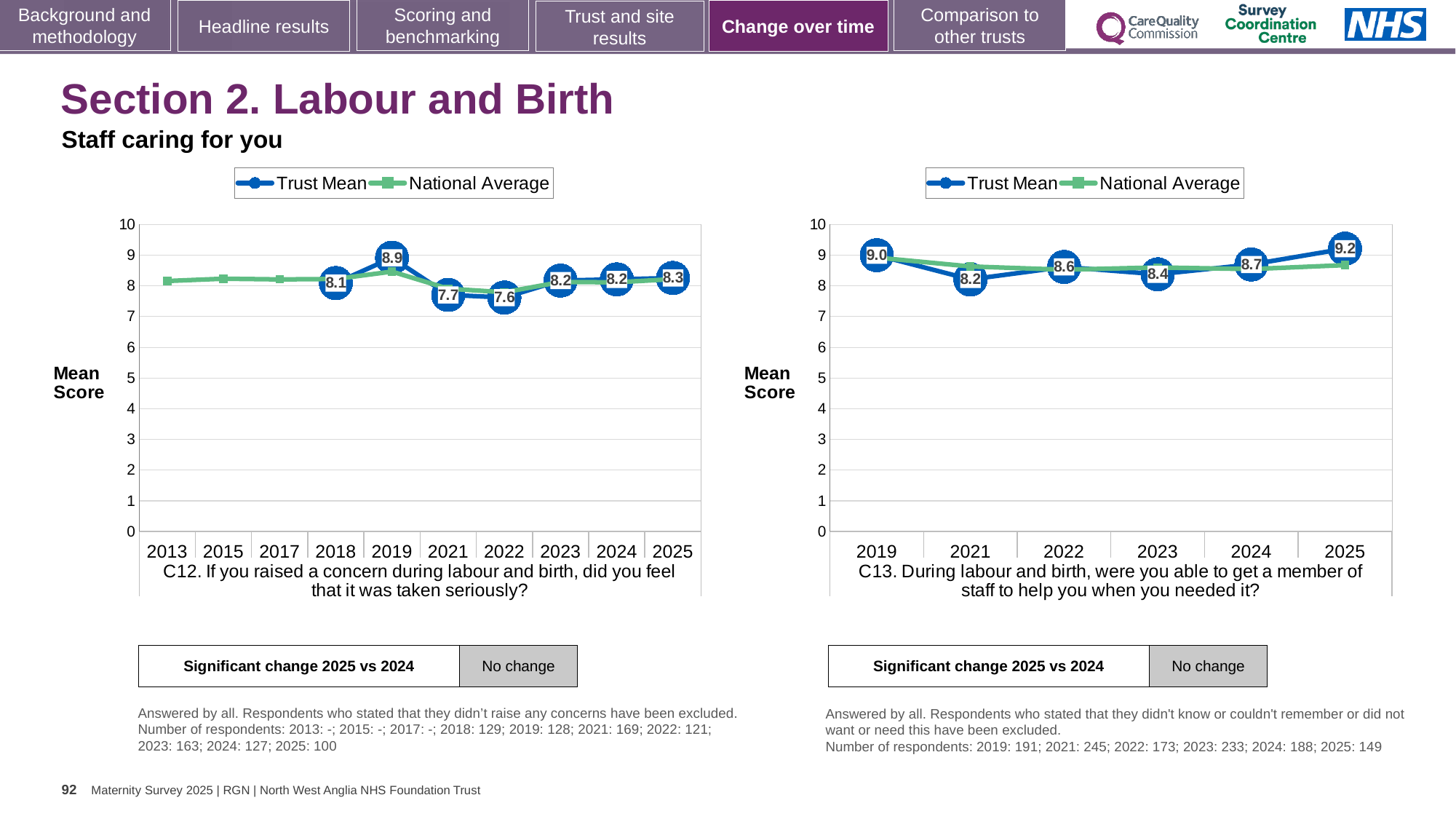
What type of chart is the C13 chart (right)? Line chart In the C13 chart (right), which year has the highest Trust Mean? 2025 In the C13 chart (right), what is the difference between the Trust Mean in 2025 and in 2024? 0.5 In the C13 chart (right), is the Trust Mean higher in 2024 or in 2023? 2024 In the C12 chart (left), which year has the lowest Trust Mean? 2022 In the C12 chart (left), what is the Trust Mean for 2019? 8.9 In the C13 chart (right), what is the Trust Mean for 2021? 8.2 In the C12 chart (left), how many years are shown on the x axis? 10 In the C12 chart (left), what is the difference between the Trust Mean in 2019 and in 2022? 1.3 In the C13 chart (right), how many series does the legend list? 2 In the C12 chart (left), what is the Trust Mean for 2025? 8.3 In the C12 chart (left), which year has the highest Trust Mean? 2019